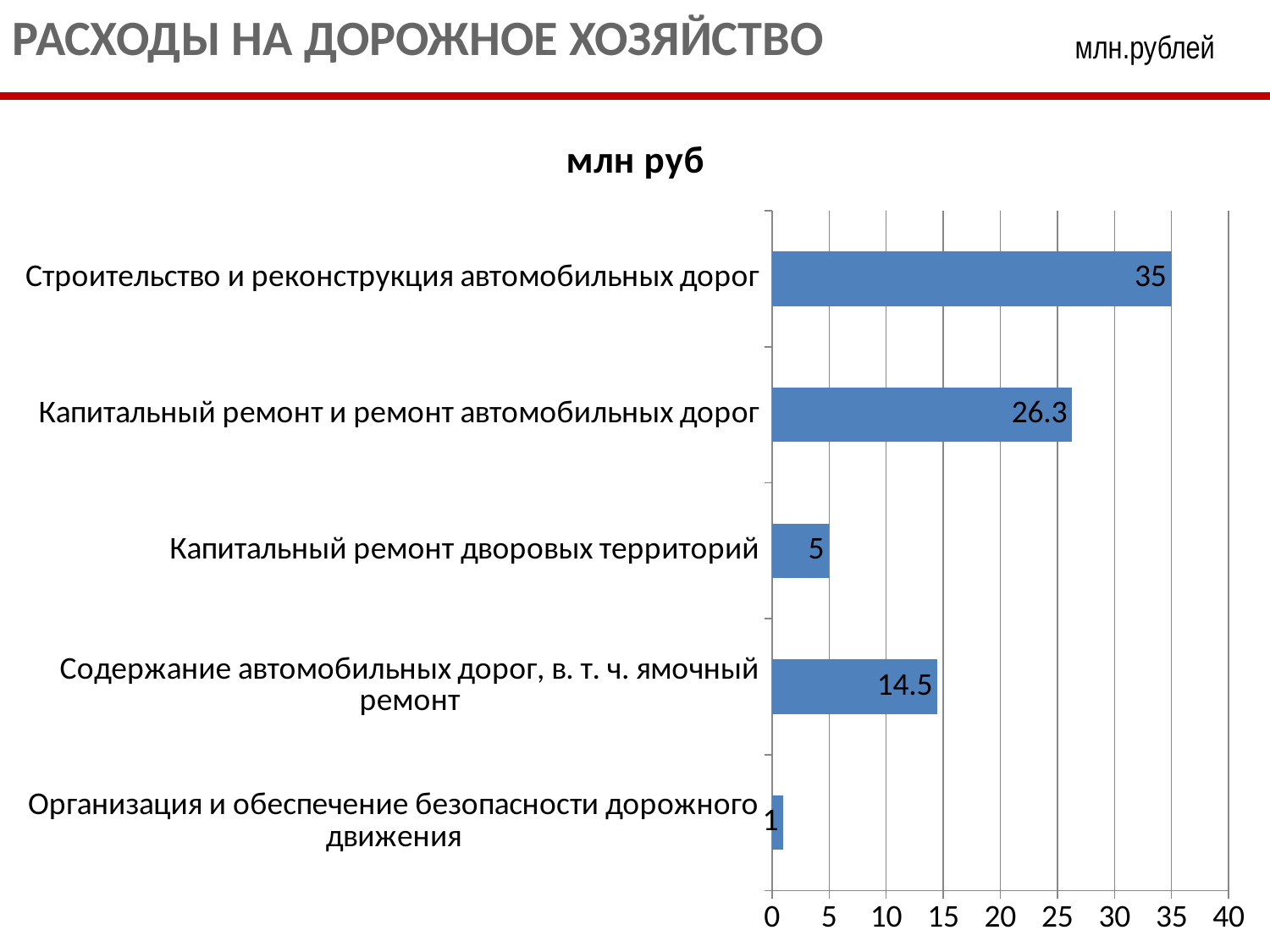
Which category has the lowest value? Организация и обеспечение безопасности дорожного движения What kind of chart is shown on the slide? bar chart What is the value for Строительство и реконструкция автомобильных дорог? 35 Is the value for Капитальный ремонт и ремонт автомобильных дорог greater or less than 30? less What is the value for Капитальный ремонт дворовых территорий? 5 How many categories are shown in the chart? 5 What is the difference between the values for Строительство и реконструкция автомобильных дорог and Капитальный ремонт и ремонт автомобильных дорог? 8.7 What is the title of the chart? млн руб Which category has the highest value? Строительство и реконструкция автомобильных дорог Which is larger: the value for Капитальный ремонт дворовых территорий or the value for Содержание автомобильных дорог, в. т. ч. ямочный ремонт? Содержание автомобильных дорог, в. т. ч. ямочный ремонт What is the value for Содержание автомобильных дорог, в. т. ч. ямочный ремонт? 14.5 What is the value for Капитальный ремонт и ремонт автомобильных дорог? 26.3